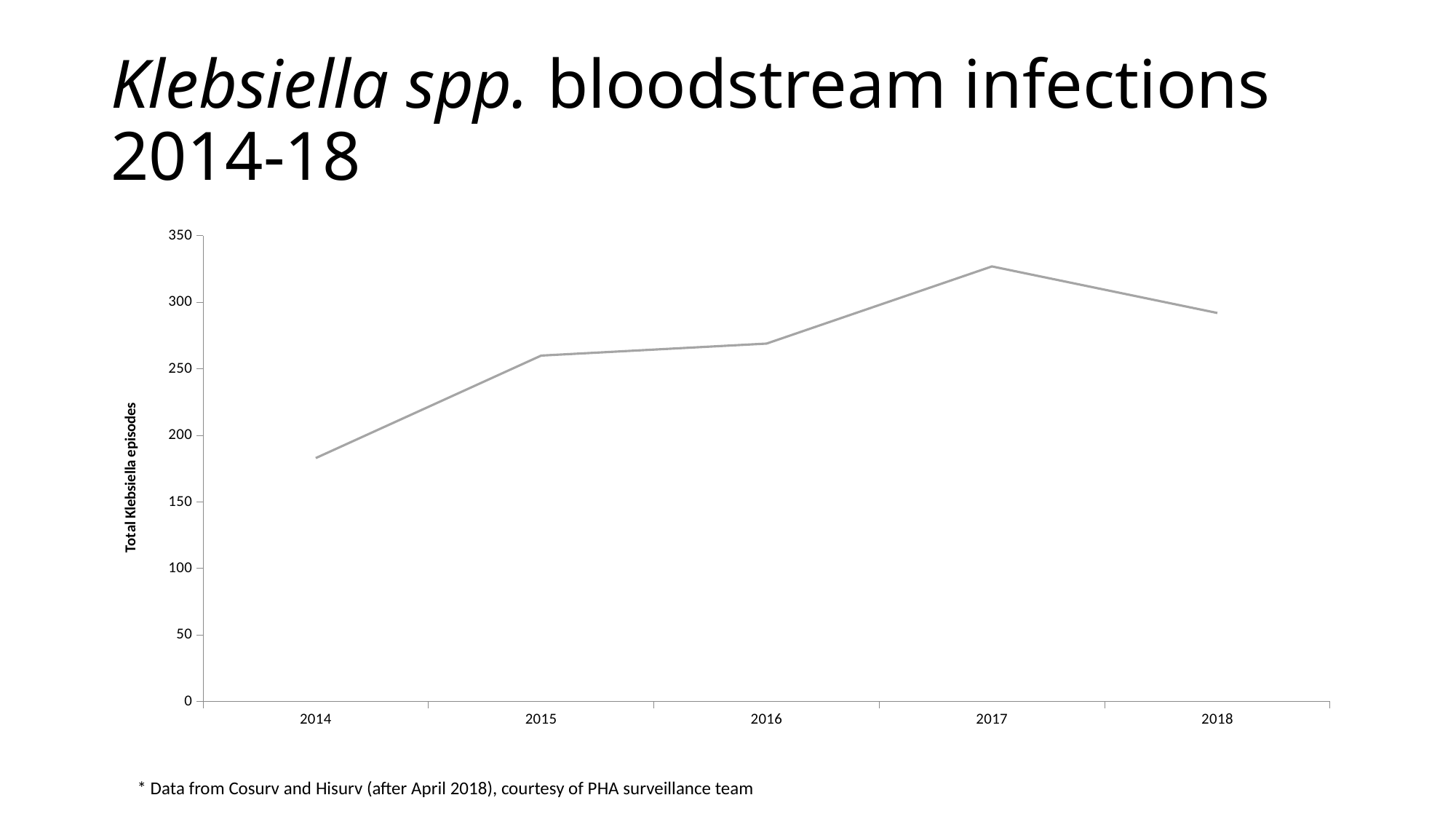
Do the values rise or fall from 2017 to 2018? fall Which year has the highest number of Klebsiella episodes? 2017 Is the value for 2014 greater or less than 200? less Do the values rise or fall from 2014 to 2017? rise Is the value for 2017 greater or less than 300? greater What kind of chart is shown on the slide? line chart Is the value for 2016 greater or less than 300? less How many years are plotted on the x axis of the chart? 5 What is the label on the vertical axis of the chart? Total Klebsiella episodes Which year has the larger value, 2014 or 2018? 2018 Which year has the lowest number of Klebsiella episodes? 2014